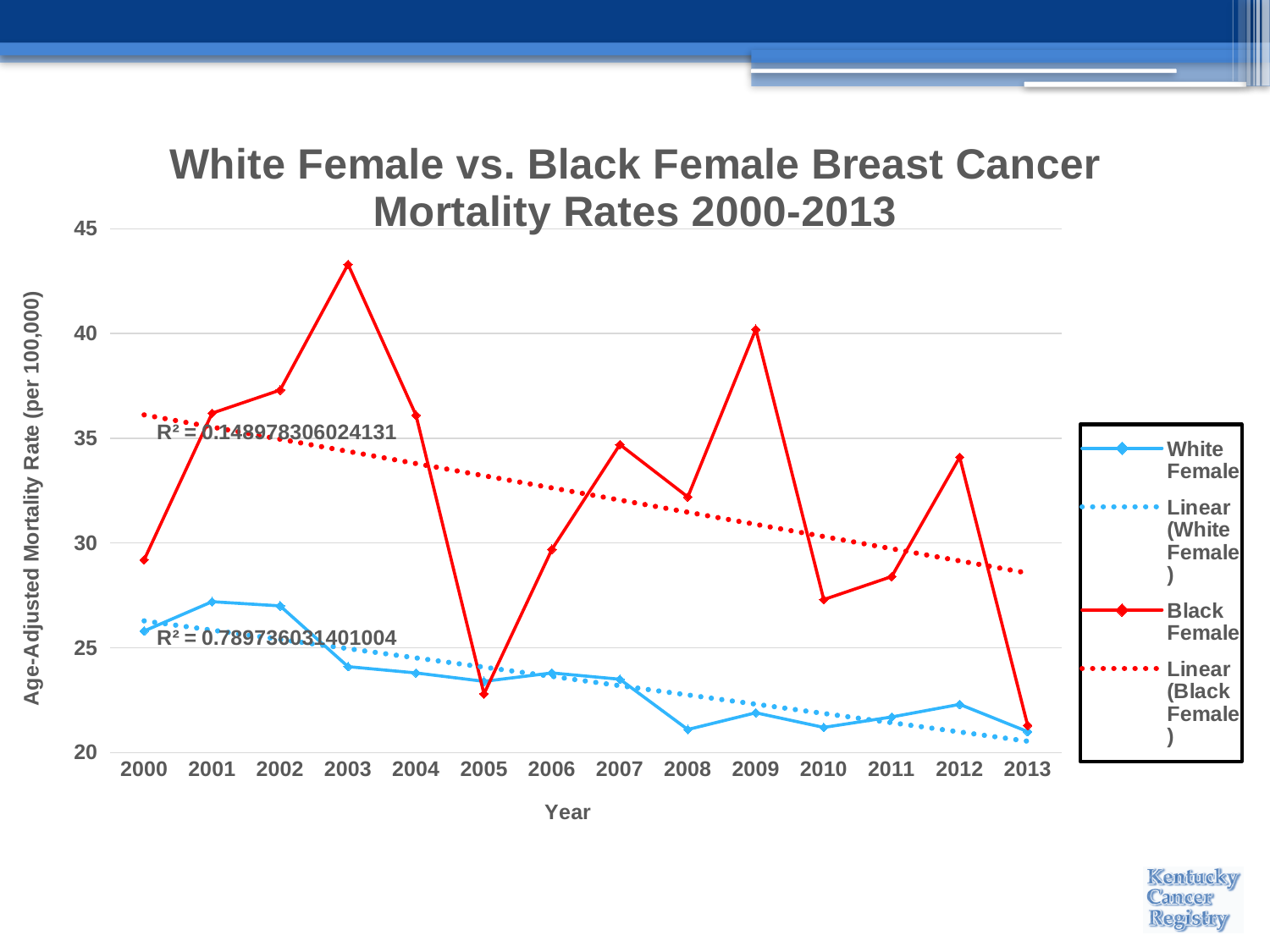
In 2003, which series has the larger value, White Female or Black Female? Black Female Is the White Female value for 2008 greater or less than 25? less Is the Black Female value for 2010 greater or less than 30? less Is the Black Female value for 2005 greater or less than 25? less How many entries does the legend list? 4 How many years are plotted along the x axis? 14 What is the title of the chart? White Female vs. Black Female Breast Cancer Mortality Rates 2000-2013 What kind of chart is shown on the slide? Line chart In which year is the Black Female mortality rate highest? 2003 Does the White Female mortality rate generally rise or fall from 2000 to 2013? Fall